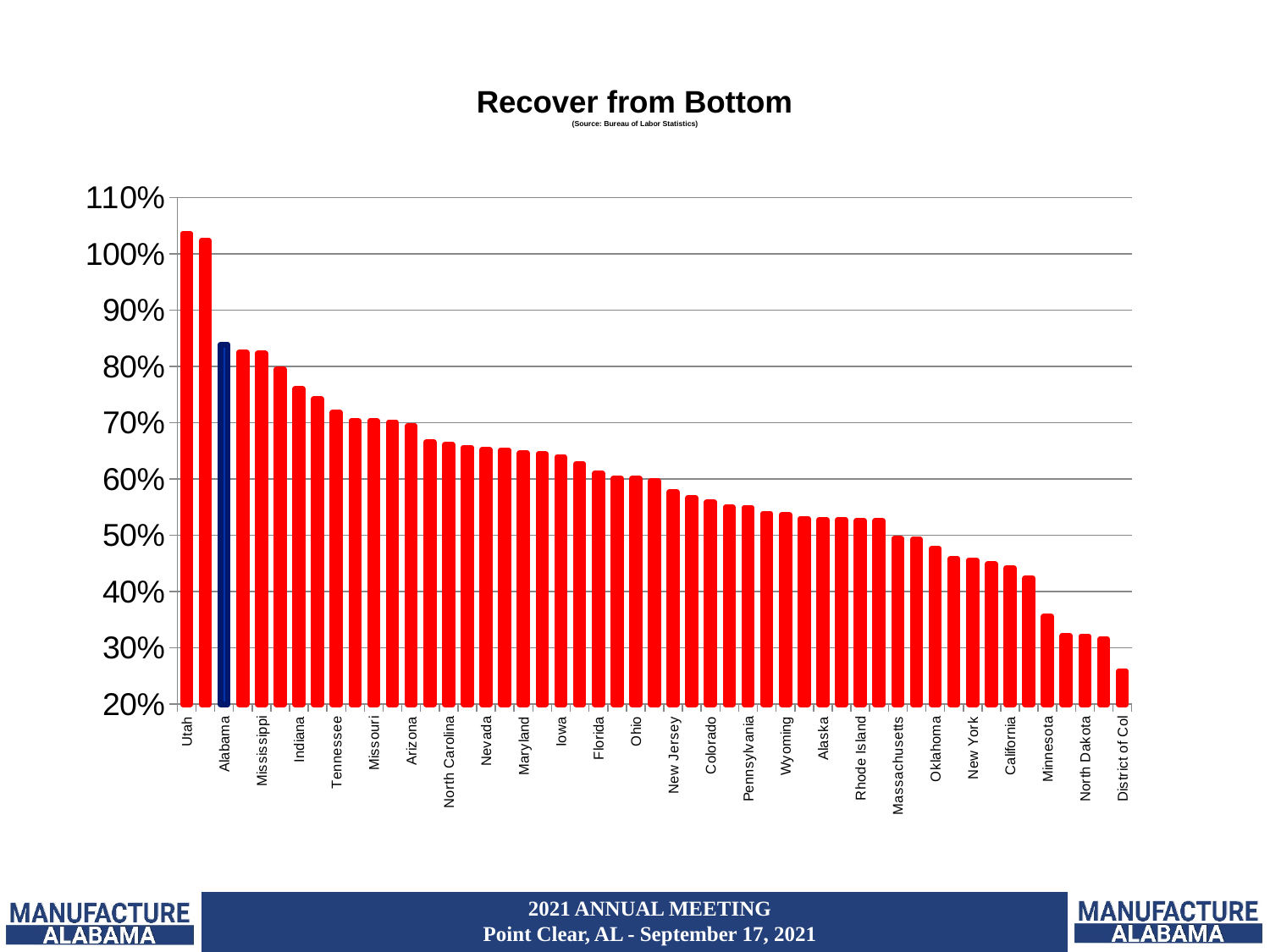
Which has the larger value, Indiana or Tennessee? Indiana Is the value for Utah greater or less than 100%? greater Is the value for Alabama greater or less than 80%? greater What kind of chart is shown on the slide? bar chart Which state has the highest value in the chart? Utah Which state's bar is coloured blue instead of red? Alabama Do the bar values rise or fall moving from left to right along the x axis? fall Is the value for Minnesota greater or less than 40%? less Which category has the lowest value in the chart? District of Col Which has the larger value, Utah or Alabama? Utah